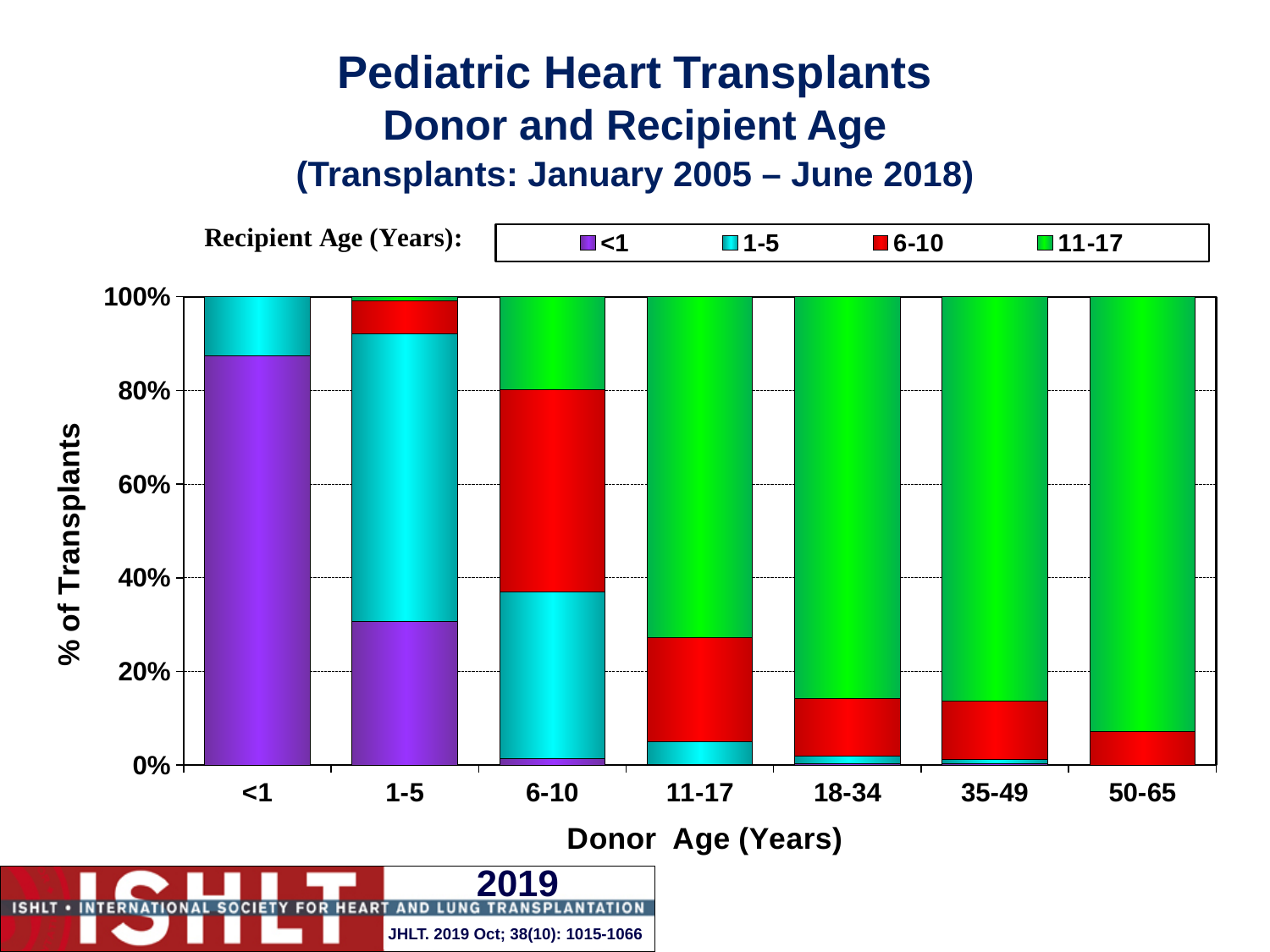
Which donor age group has the largest share of recipients aged <1? <1 What is the title of the x axis? Donor Age (Years) Is the share of recipients aged 6-10 for donor age 50-65 greater or less than 20%? less Which donor age group has a larger share of recipients aged <1: <1 or 1-5? <1 Does the share of recipients aged 11-17 rise or fall as donor age increases along the x axis? rise Is the share of recipients aged 11-17 for donor age 11-17 greater or less than 60%? greater Is the share of recipients aged <1 for donor age <1 greater or less than 80%? greater Which donor age group has the largest share of recipients aged 11-17? 50-65 What kind of chart is shown on the slide? Stacked bar chart Which donor age group has the largest share of recipients aged 6-10? 6-10 How many recipient age groups does the legend list? 4 How many donor age groups are shown along the x axis? 7